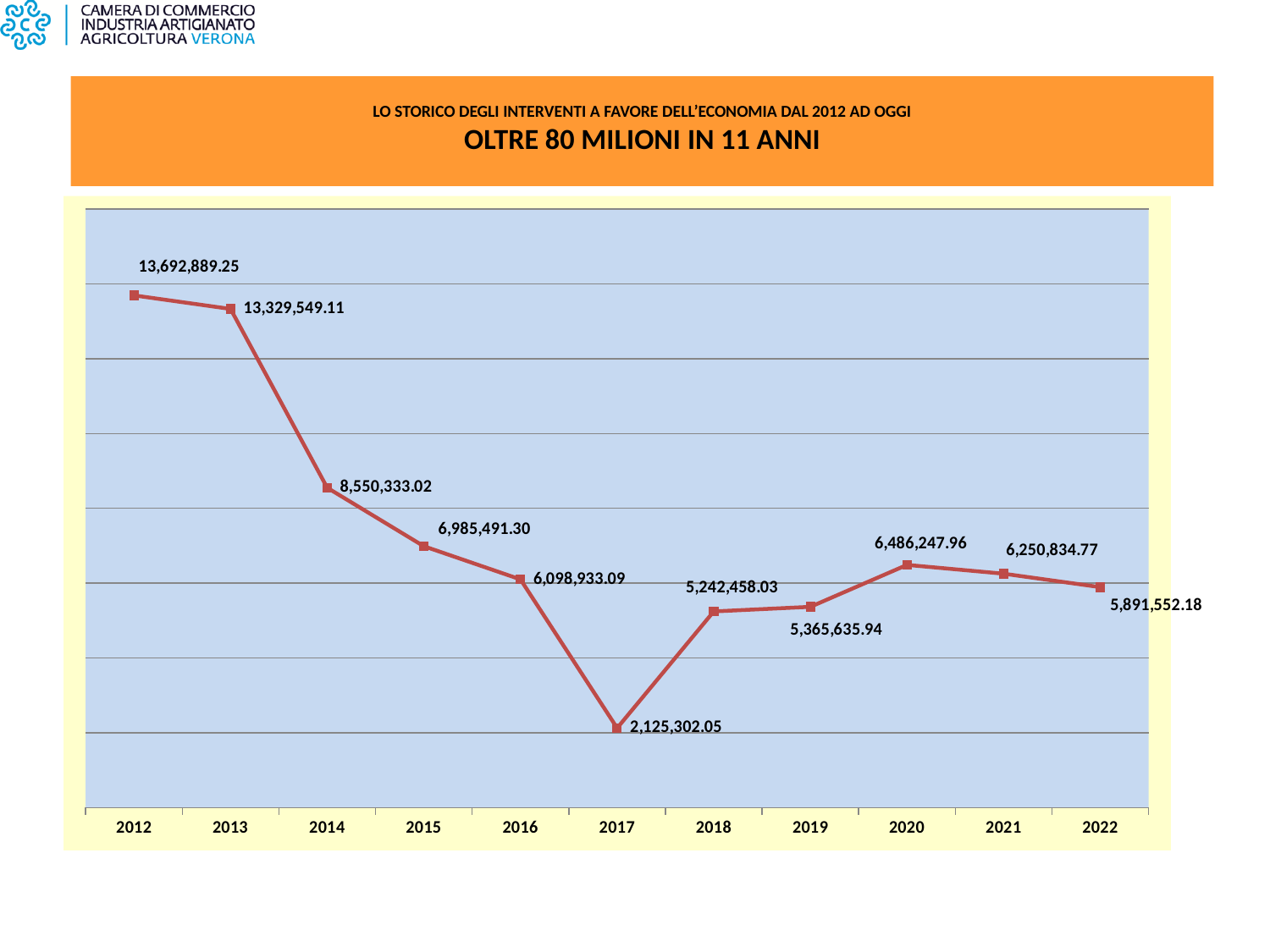
What is the value for 2020? 6,486,247.96 What is the difference between the values for 2012 and 2013? 363,340.14 What kind of chart is shown on the slide? Line chart Which year has the larger value, 2018 or 2019? 2019 How many years are plotted on the chart? 11 Which year has the highest value? 2012 Do the values rise or fall from 2012 to 2017? Fall What is the difference between the values for 2020 and 2021? 235,413.19 What is the value for 2017? 2,125,302.05 Which year has the lowest value? 2017 What is the value for 2022? 5,891,552.18 What is the value for 2012? 13,692,889.25